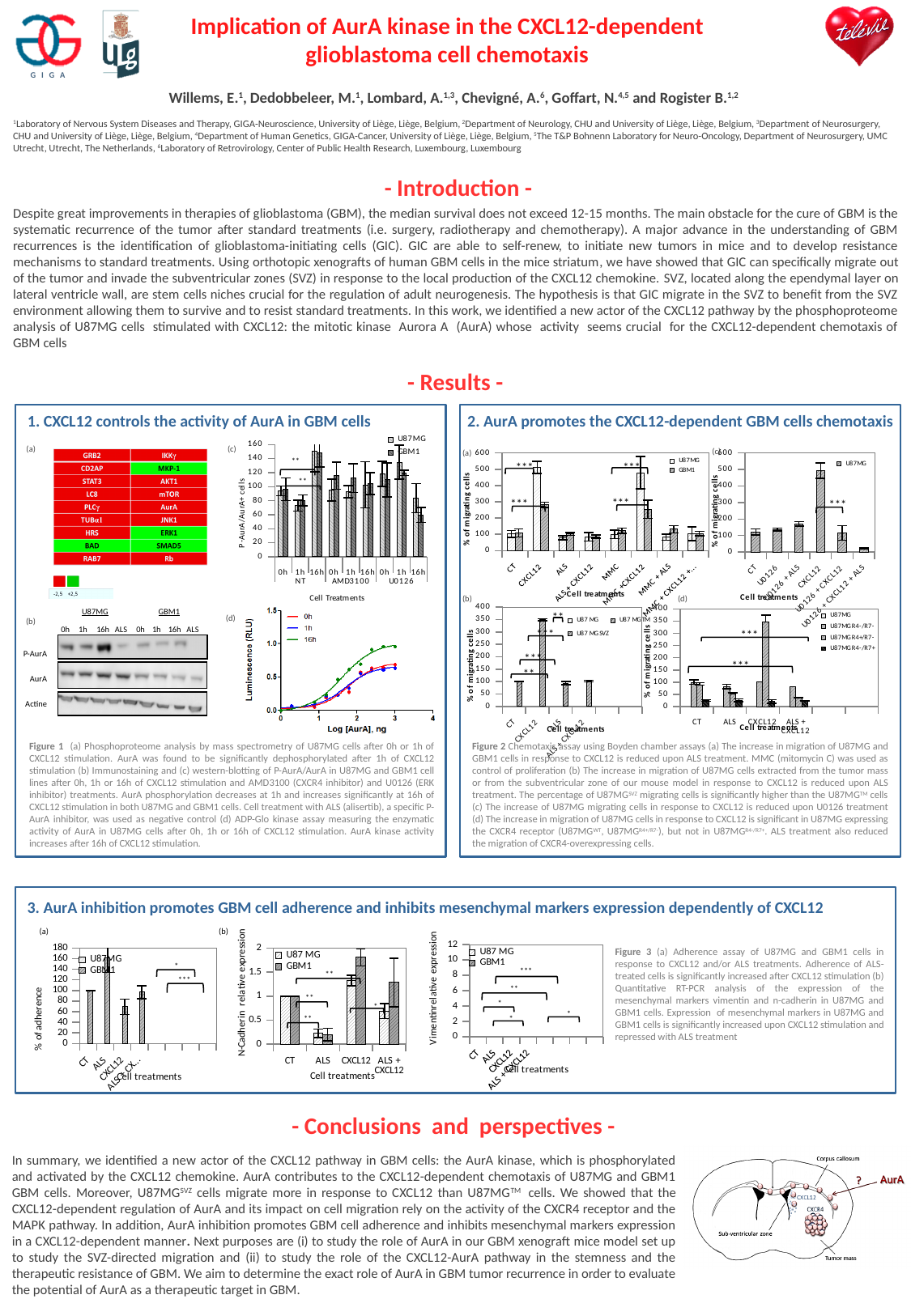
In Figure 1(d), the ADP-Glo kinase assay, which series does the legend list? 0h, 1h, 16h How many series does the legend of Figure 1(c) list? 2 What is the y-axis label of Figure 3(a)? % of adherence In Figure 2(c), is the value for CXCL12 greater or less than 300? greater In Figure 2(b), which is larger for the CXCL12 treatment: U87 MG or U87 MG SVZ? U87 MG SVZ In Figure 2(a), which cell treatment has the highest percentage of migrating cells for GBM1? CXCL12 In Figure 1(d), is the 16h luminescence value at Log [AurA] = 3 greater or less than 0.5? greater In Figure 2(c), which cell treatment has the highest percentage of migrating cells? CXCL12 In Figure 2(a), is the GBM1 value for CXCL12 greater or less than 400? less How many cell treatments are shown on the x axis of Figure 3(b), the N-Cadherin relative expression chart? 4 What kind of chart is Figure 1(c), showing P-AurA/AurA+ cells? bar chart How many series does the legend of Figure 2(d) list? 4